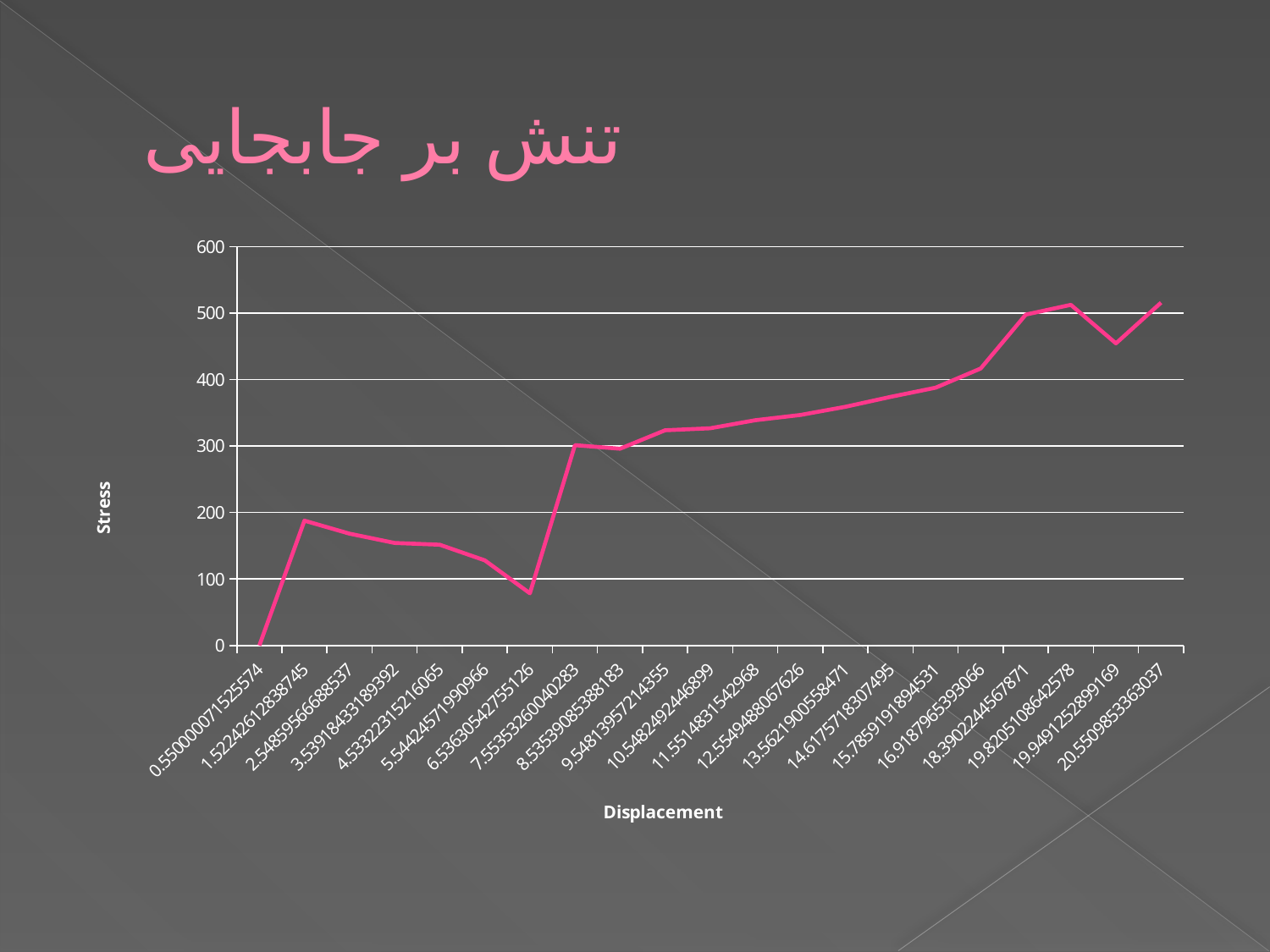
Is the stress value at displacement 1.52242612838745 greater or less than 200? less What kind of chart is shown on the slide? line chart What is the title of the horizontal axis of the chart? Displacement Which has the higher stress value: displacement 18.3902244567871 or displacement 19.9491252899169? 18.3902244567871 Is the stress value at displacement 6.53630542755126 greater or less than 100? less Is the stress value at displacement 19.9491252899169 greater or less than 500? less Which displacement value has the lowest stress? 0.550000071525574 What is the title of the vertical axis of the chart? Stress How many data points are plotted on the line? 21 Which has the higher stress value: displacement 6.53630542755126 or displacement 7.55353260040283? 7.55353260040283 Overall, does the stress rise or fall as displacement increases along the x axis? rise